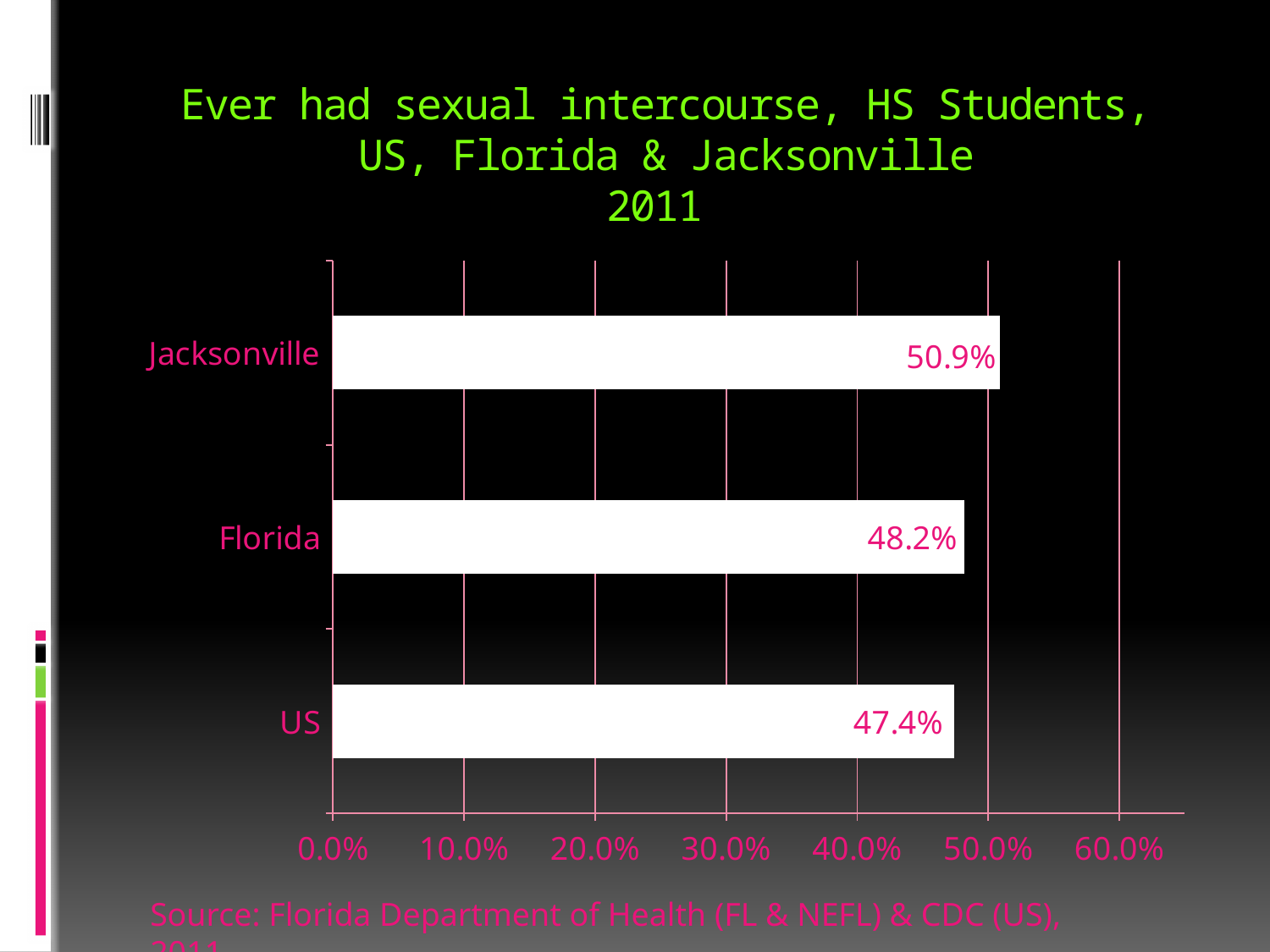
What is the difference between the Jacksonville and US values? 3.5% Which category has the highest value? Jacksonville What kind of chart is shown on the slide? Bar chart What is the value for Jacksonville? 50.9% What is the title of the chart? Ever had sexual intercourse, HS Students, US, Florida & Jacksonville 2011 What is the value for US? 47.4% What is the difference between the Florida and US values? 0.8% Which is larger, the value for Jacksonville or the value for Florida? Jacksonville How many categories are shown in the chart? 3 What is the value for Florida? 48.2% Which category has the lowest value? US Is the value for Jacksonville greater or less than 50.0%? greater